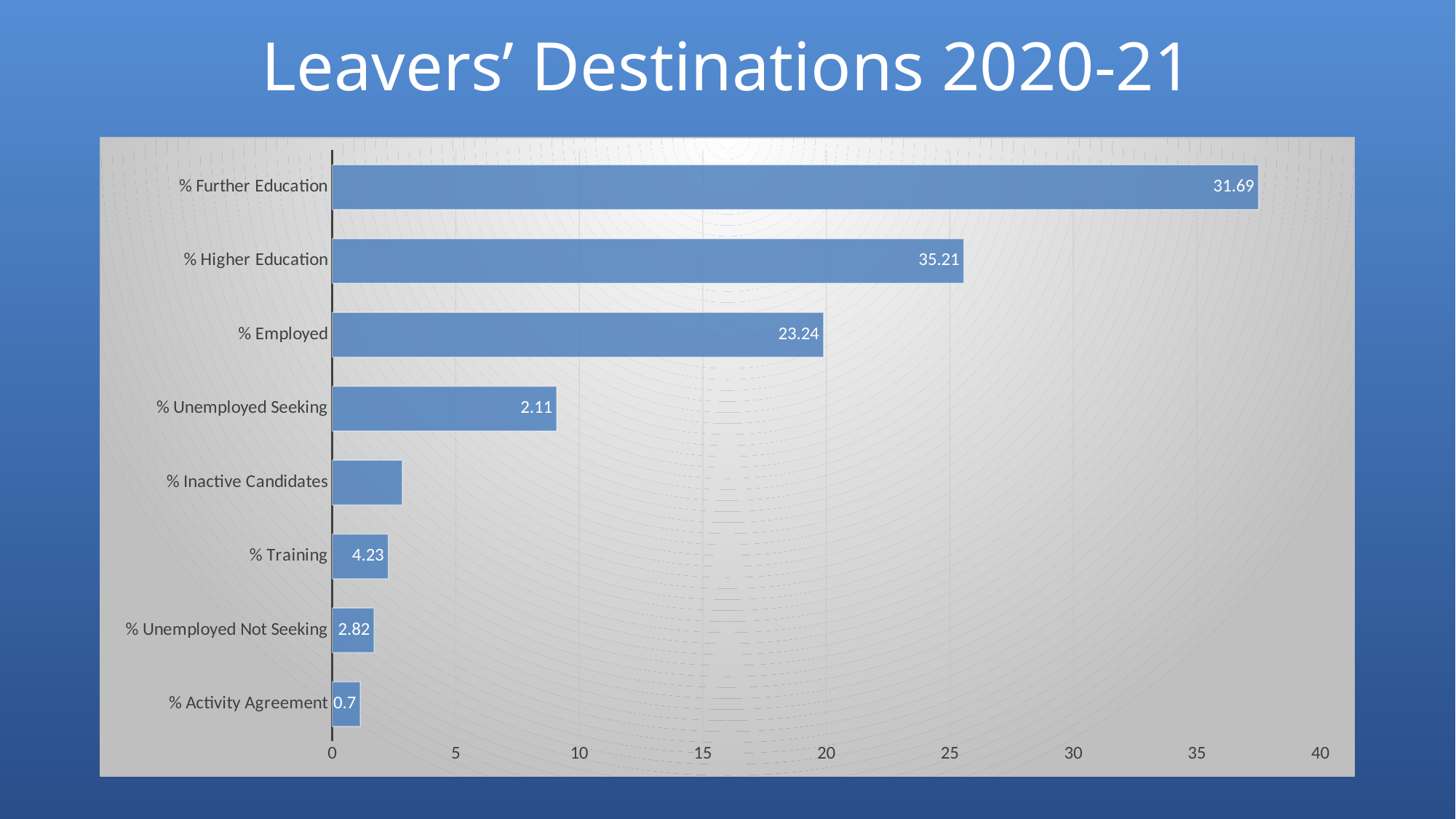
What kind of chart is shown on the slide? bar chart What is the value shown for % Training? 4.23 How many categories are shown in the chart? 8 What is the title of the slide? Leavers' Destinations 2020-21 Which is larger, the value for % Employed or the value for % Training? % Employed What is the value shown for % Unemployed Not Seeking? 2.82 What is the value shown for % Further Education? 31.69 What is the value shown for % Employed? 23.24 What is the value shown for % Activity Agreement? 0.7 What is the value shown for % Higher Education? 35.21 Which category has the lowest value? % Activity Agreement Is the value for % Inactive Candidates greater or less than 5? less